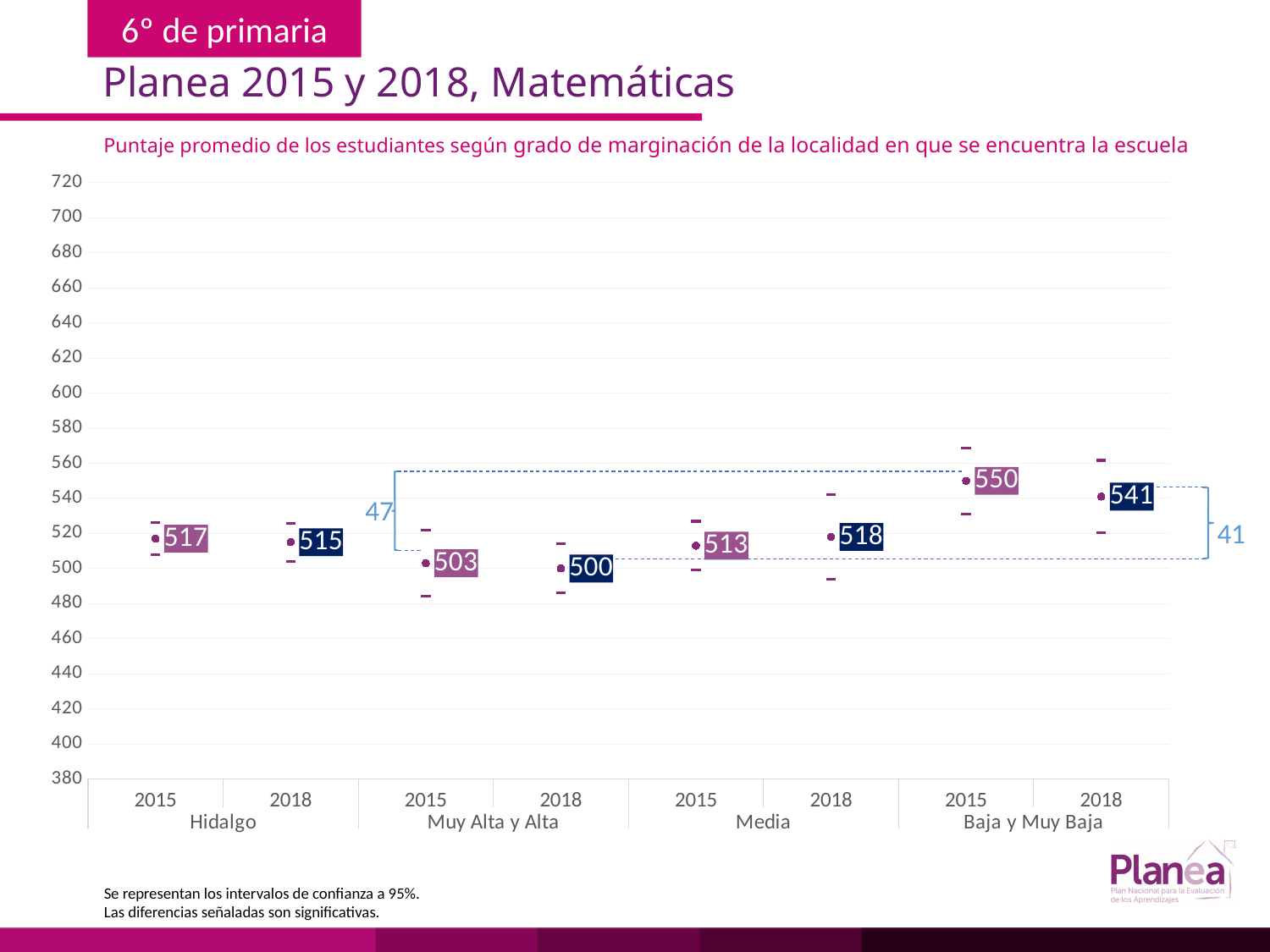
What is the average score for the Muy Alta y Alta marginación group in 2018? 500 Which group and year has the lowest average score? Muy Alta y Alta, 2018 What is the difference between the 2015 scores of the Baja y Muy Baja group and the Muy Alta y Alta group? 47 What is the average score for the Media group in 2018? 518 What is the average score for the Baja y Muy Baja group in 2015? 550 What is the difference between the 2018 scores of the Baja y Muy Baja group and the Muy Alta y Alta group? 41 Which group and year has the highest average score? Baja y Muy Baja, 2015 Is the 2018 score for the Baja y Muy Baja group greater or less than 520? greater Which is larger, the Media score in 2015 or in 2018? 2018 What is the subtitle of the chart? Puntaje promedio de los estudiantes según grado de marginación de la localidad en que se encuentra la escuela What is the average score for Hidalgo in 2015? 517